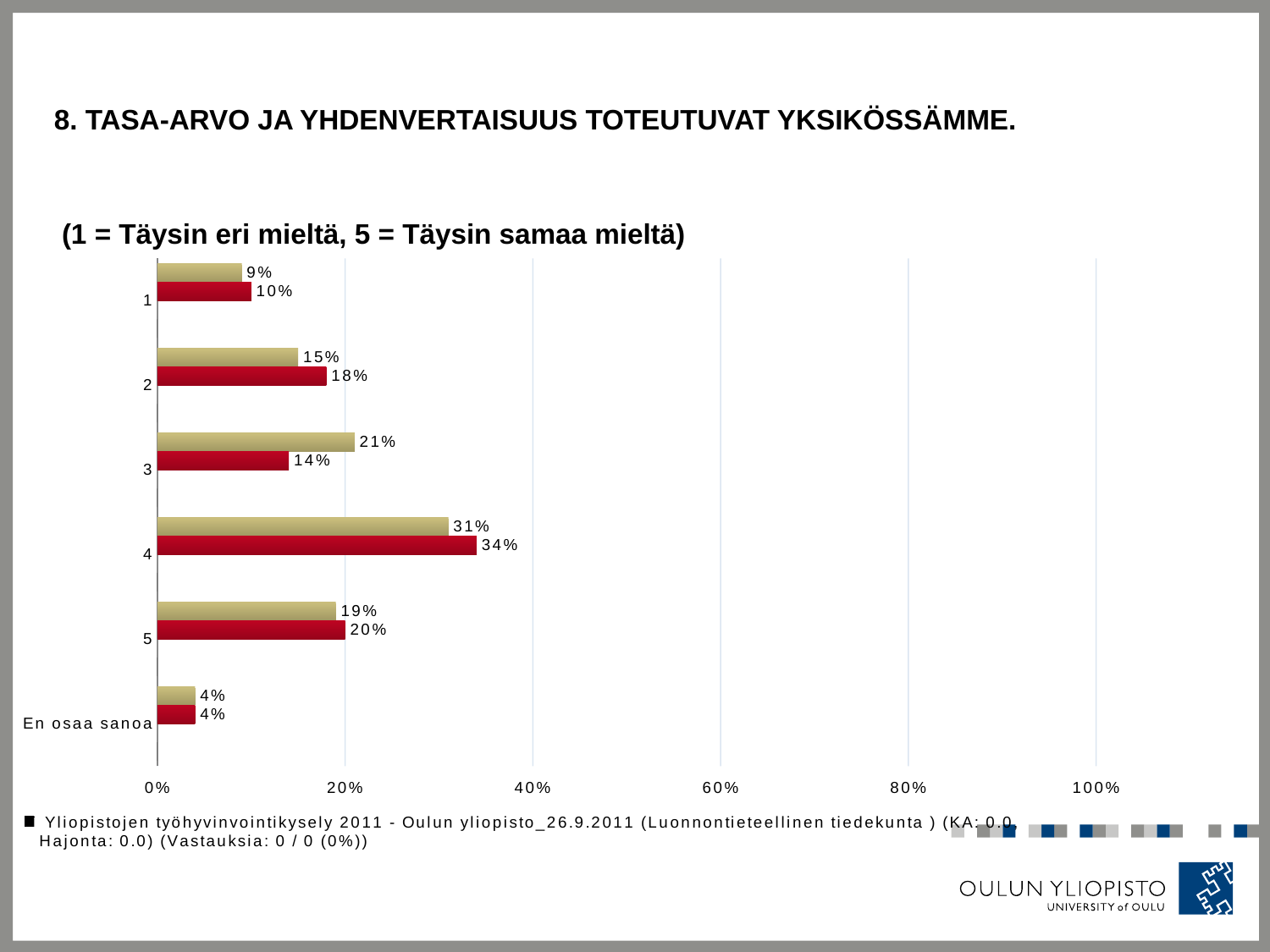
What is the value of the red bar for category 1? 10% Which category has the highest red bar? 4 Which category has the lowest tan bar? En osaa sanoa What is the value of the tan bar for category 3? 21% For category 4, how much larger is the red bar than the tan bar? 3 percentage points For category 2, which bar is larger, the red bar or the tan bar? the red bar How many categories are shown on the vertical axis of the chart? 6 What kind of chart is shown on the slide? bar chart For category 3, how much larger is the tan bar than the red bar? 7 percentage points What is the value of the tan bar for 'En osaa sanoa'? 4% What is the value of the red bar for category 4? 34% How many entries does the chart legend list? 1